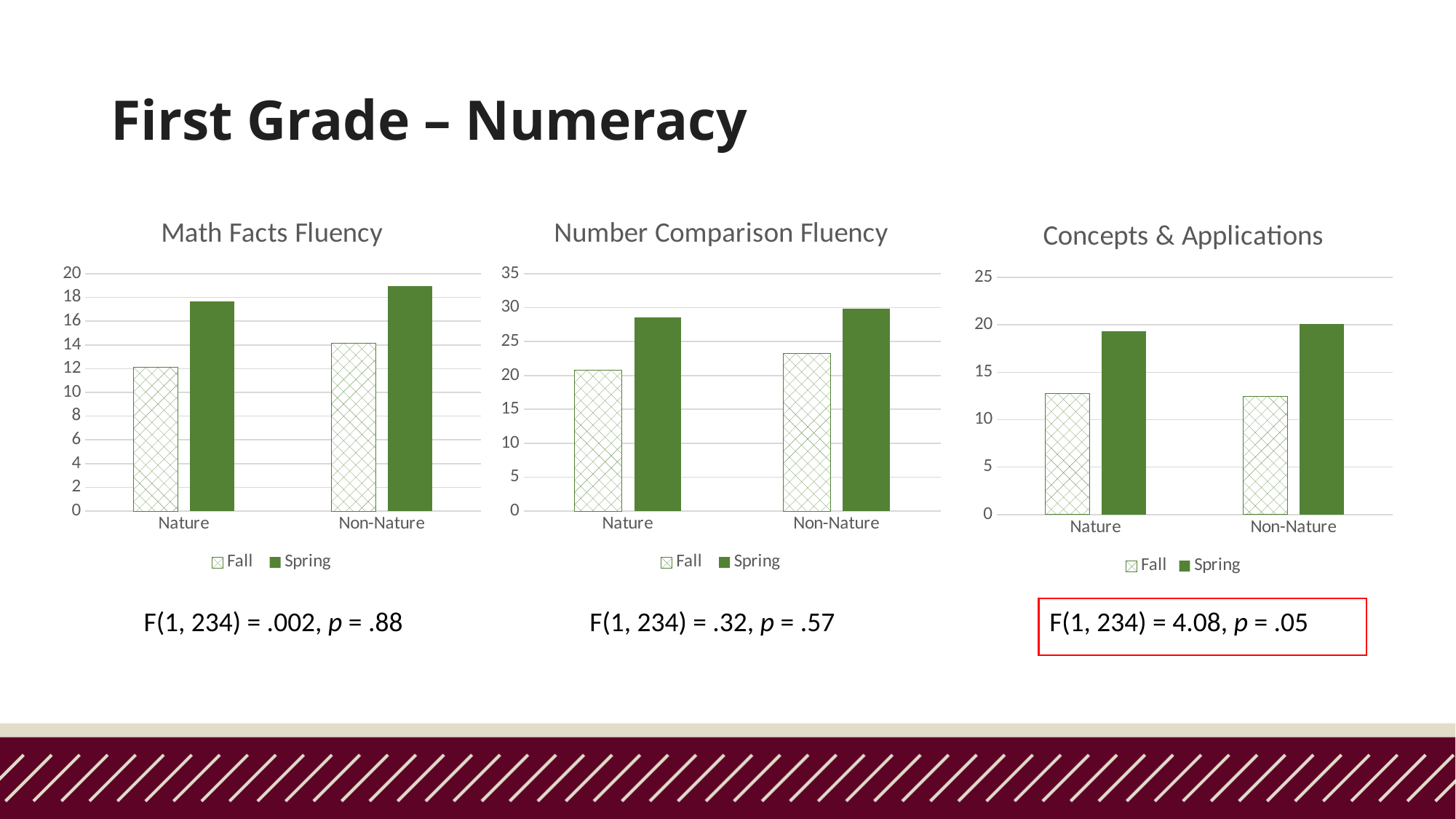
In the Math Facts Fluency chart, is the Spring value for Non-Nature greater or less than 18? greater In the Number Comparison Fluency chart, is the Fall value for Nature greater or less than 25? less What kind of chart is the Math Facts Fluency chart? bar chart In the Number Comparison Fluency chart, is the Spring value for Non-Nature greater or less than 25? greater In the Number Comparison Fluency chart, which bar is the highest? Spring, Non-Nature In the Number Comparison Fluency chart, how many categories are shown on the x axis? 2 What is the title of the rightmost chart on the slide? Concepts & Applications In the Math Facts Fluency chart, which is larger: the Spring value for Nature or the Spring value for Non-Nature? Non-Nature In the Math Facts Fluency chart, how many series does the legend list? 2